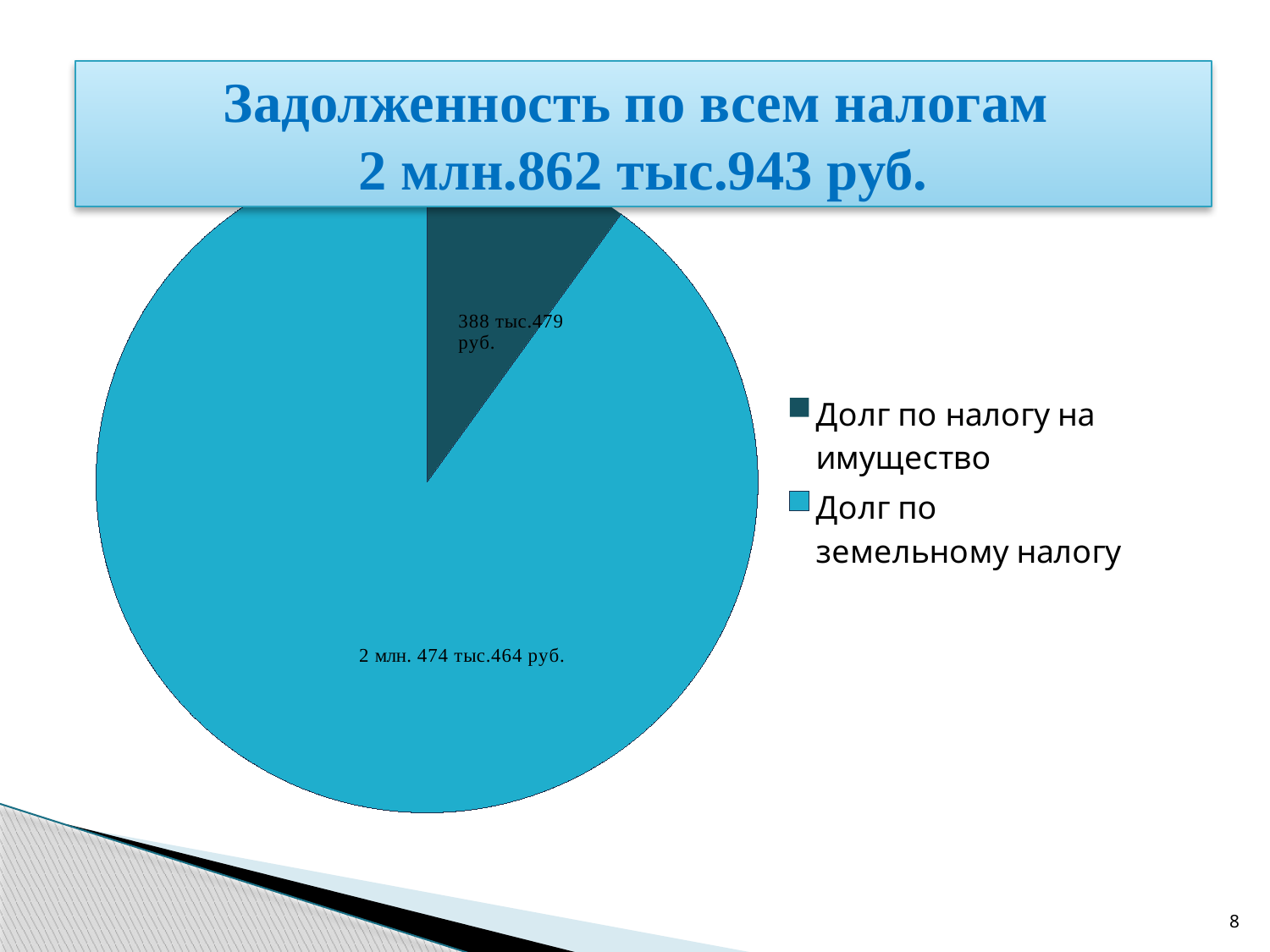
Which category has the largest slice of the pie? Долг по земельному налогу How many slices does the pie chart have? 2 What value is shown for the slice "Долг по земельному налогу"? 2 млн. 474 тыс.464 руб. What kind of chart is shown on the slide? Pie chart Which is larger: the debt on property tax (Долг по налогу на имущество) or the debt on land tax (Долг по земельному налогу)? Долг по земельному налогу What value is shown for the slice "Долг по налогу на имущество"? 388 тыс.479 руб. How many entries does the legend list? 2 Which category has the smallest slice of the pie? Долг по налогу на имущество What total debt for all taxes is stated in the slide title? 2 млн.862 тыс.943 руб. Which legend entry is represented by the dark teal slice? Долг по налогу на имущество